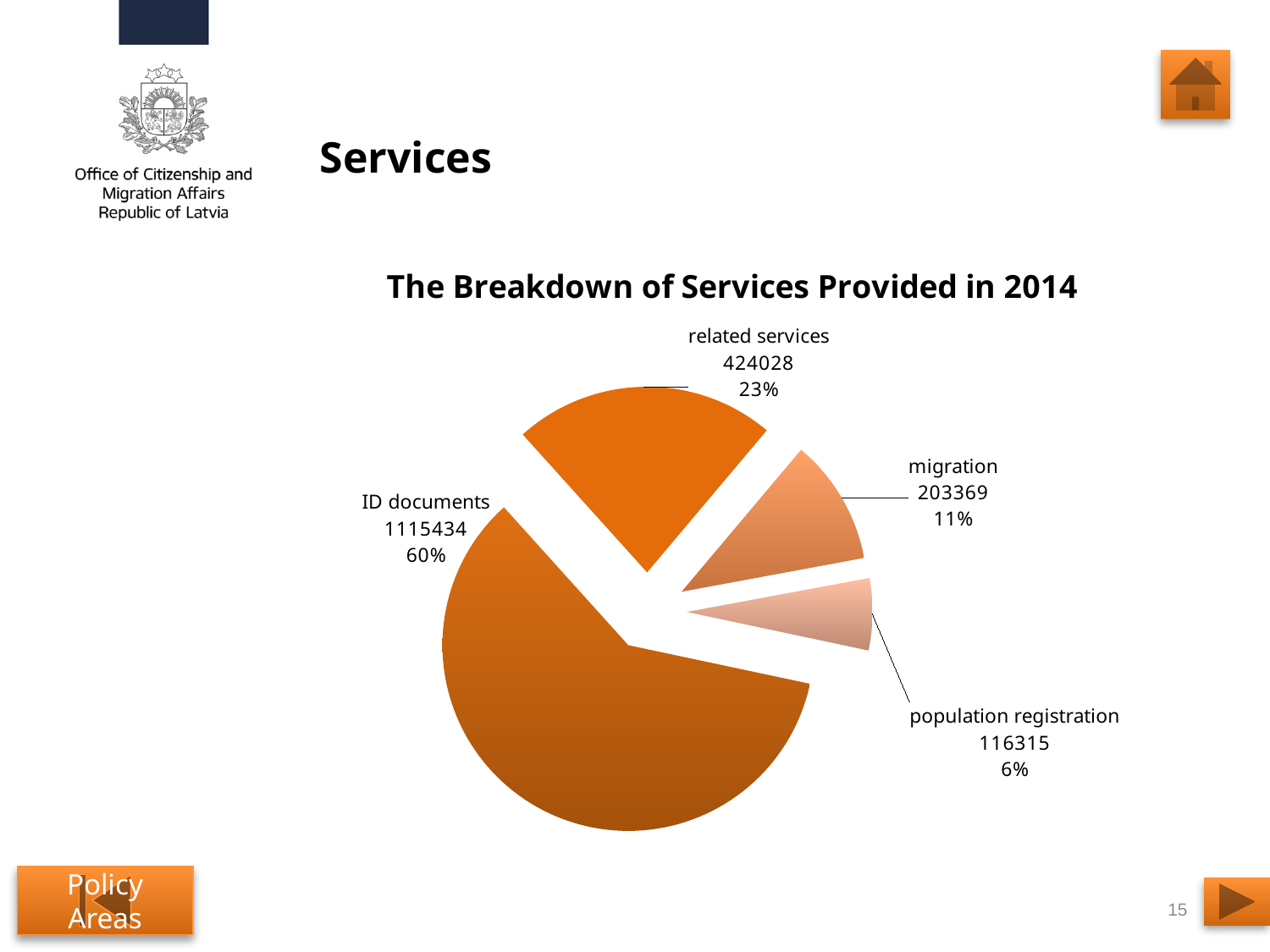
Which category has the smallest slice? population registration What is the value for ID documents? 1115434 What share of the pie does population registration represent? 6% What is the value for related services? 424028 What is the title of the chart? The Breakdown of Services Provided in 2014 What is the difference between the values for related services and migration? 220659 What share of the pie does ID documents represent? 60% Which category has the largest slice? ID documents What kind of chart is shown on the slide? pie chart What is the value for migration? 203369 What is the value for population registration? 116315 How many slices does the pie chart have? 4